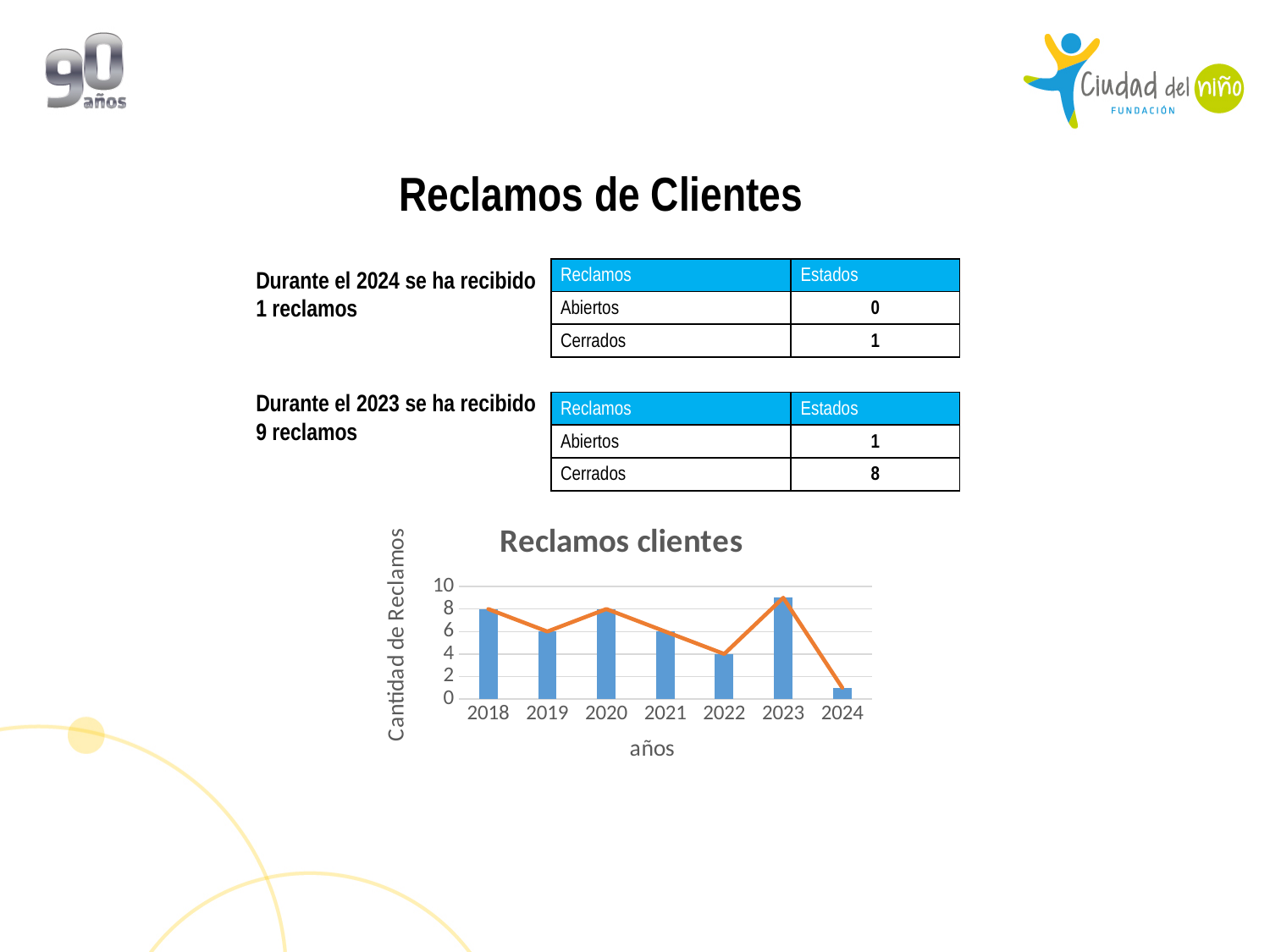
Is the value for 2023 in the Reclamos clientes chart greater or less than 8? greater What is the label of the vertical axis of the Reclamos clientes chart? Cantidad de Reclamos Which year has more reclamos, 2020 or 2022? 2020 How many years are shown on the x axis of the Reclamos clientes chart? 7 Is the value for 2024 in the Reclamos clientes chart greater or less than 2? less How many reclamos does the chart show for 2019? 6 Which year has the lowest number of reclamos in the Reclamos clientes chart? 2024 What is the title of the chart on the slide? Reclamos clientes Which year has the highest number of reclamos in the Reclamos clientes chart? 2023 How many reclamos does the chart show for 2022? 4 What is the difference between the reclamos in 2018 and in 2019? 2 How many reclamos does the chart show for 2018? 8